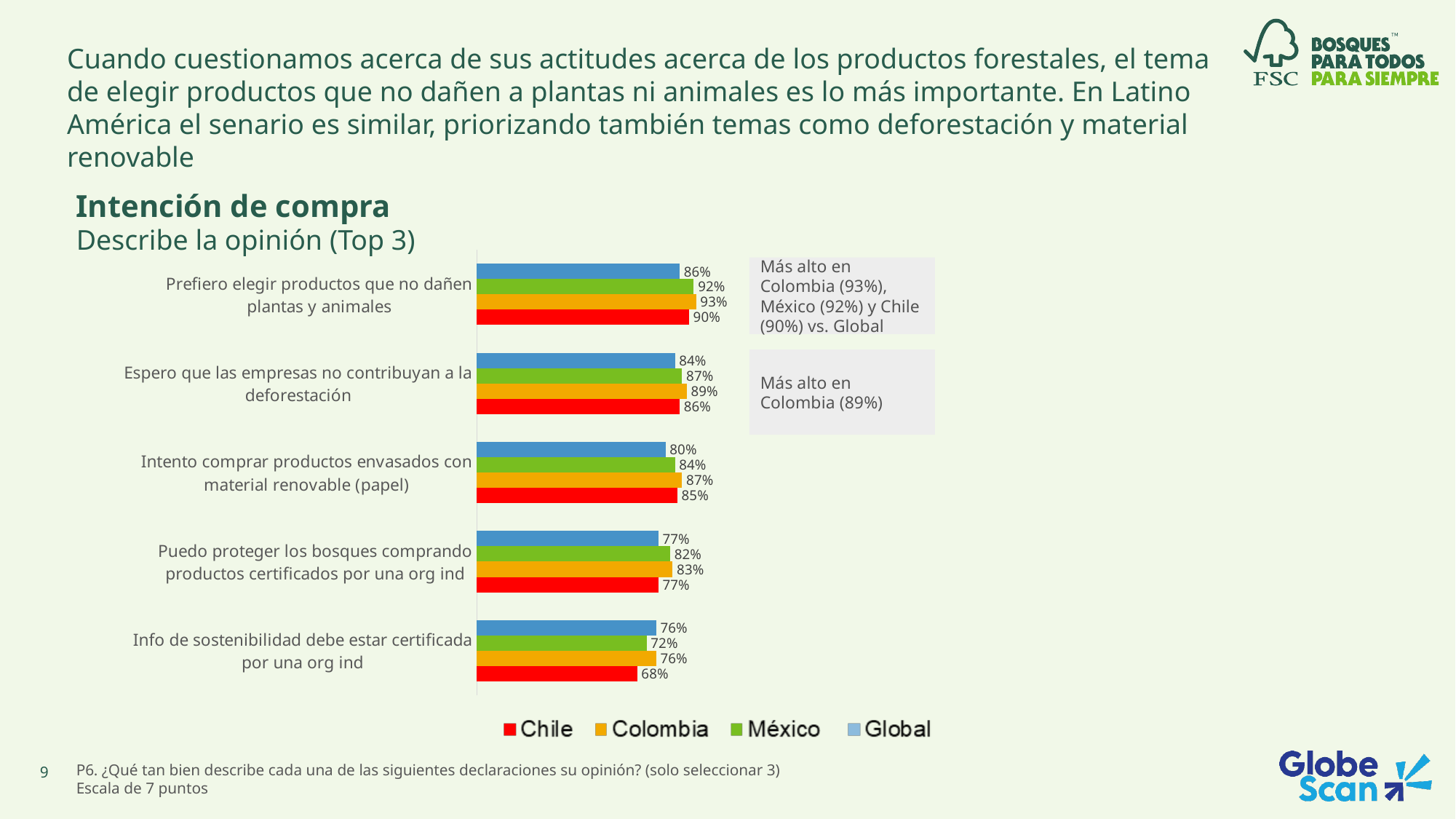
What is the difference between the Colombia and Global values for "Prefiero elegir productos que no dañen plantas y animales"? 7 percentage points What is the Global value for "Intento comprar productos envasados con material renovable (papel)"? 80% Which is larger for "Intento comprar productos envasados con material renovable (papel)": Chile or México? Chile What is the value for Chile on "Info de sostenibilidad debe estar certificada por una org ind"? 68% What is the value for Colombia on "Prefiero elegir productos que no dañen plantas y animales"? 93% What is the value for México on "Espero que las empresas no contribuyan a la deforestación"? 87% Which series has the lowest value for "Info de sostenibilidad debe estar certificada por una org ind"? Chile Which colour represents Colombia in the chart? Orange How many series does the legend list? 4 What kind of chart is shown on the slide? Bar chart Which series has the highest value for "Puedo proteger los bosques comprando productos certificados por una org ind"? Colombia How many statements (categories) are shown in the chart? 5